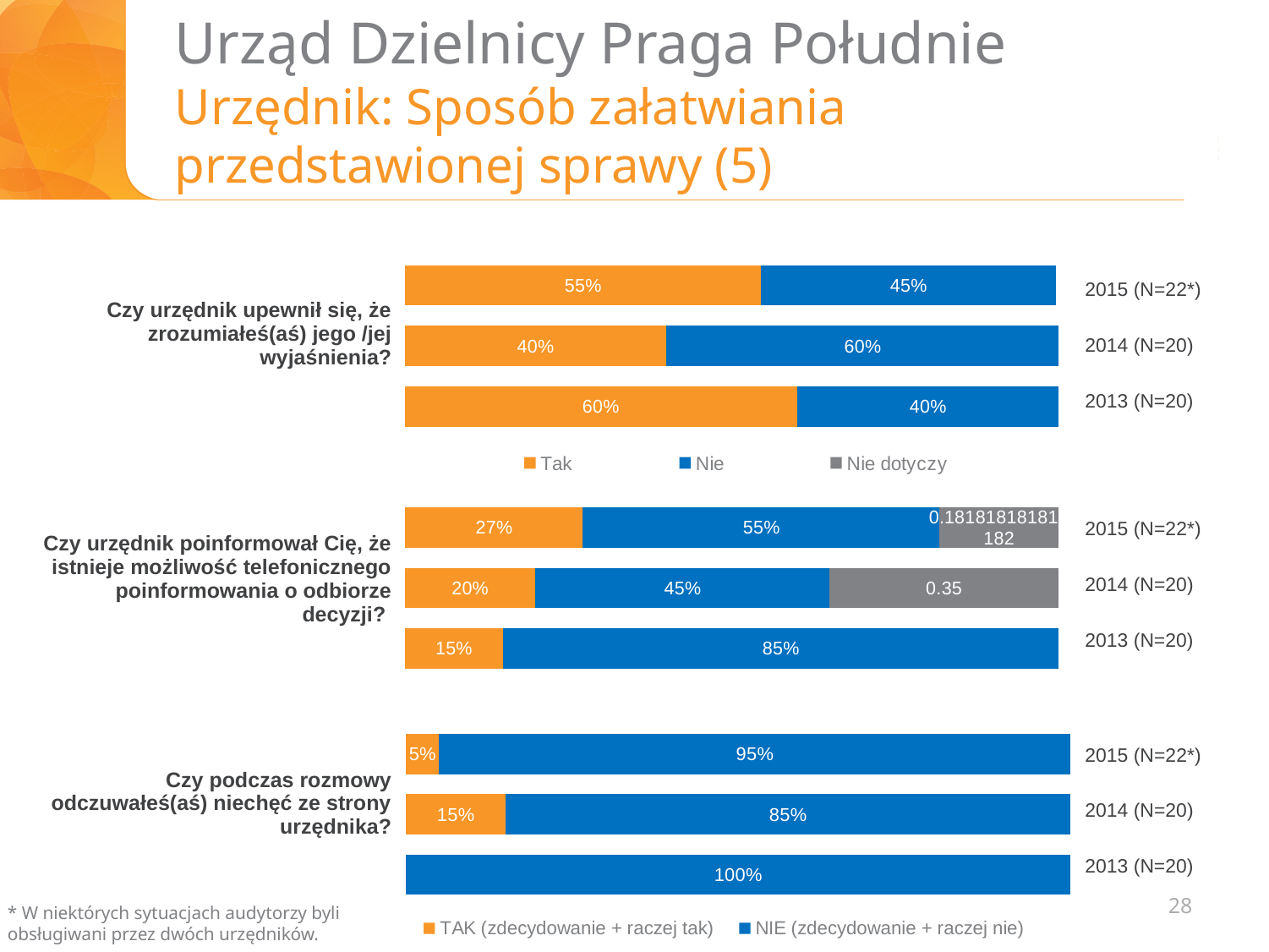
In the chart for "Czy podczas rozmowy odczuwałeś(aś) niechęć ze strony urzędnika?", is the TAK value for 2014 (N=20) larger or smaller than the TAK value for 2015 (N=22*)? larger In the chart for "Czy urzędnik poinformował Cię, że istnieje możliwość telefonicznego poinformowania o odbiorze decyzji?", which year has the lowest Tak value? 2013 (N=20) In the chart for "Czy urzędnik poinformował Cię, że istnieje możliwość telefonicznego poinformowania o odbiorze decyzji?", what is the Nie dotyczy value shown for 2014 (N=20)? 0.35 In the chart for "Czy urzędnik upewnił się, że zrozumiałeś(aś) jego /jej wyjaśnienia?", how many entries does the legend list? 3 In the chart for "Czy urzędnik upewnił się, że zrozumiałeś(aś) jego /jej wyjaśnienia?", what is the Nie value for 2014 (N=20)? 60% In the chart for "Czy urzędnik upewnił się, że zrozumiałeś(aś) jego /jej wyjaśnienia?", which year has the highest Tak value? 2013 (N=20) What type of chart is used on this slide? Stacked bar chart In the chart for "Czy urzędnik poinformował Cię, że istnieje możliwość telefonicznego poinformowania o odbiorze decyzji?", what is the difference between the Nie values for 2013 (N=20) and 2014 (N=20)? 40% In the chart for "Czy urzędnik poinformował Cię, że istnieje możliwość telefonicznego poinformowania o odbiorze decyzji?", what is the Nie value for 2013 (N=20)? 85% In the chart for "Czy urzędnik upewnił się, że zrozumiałeś(aś) jego /jej wyjaśnienia?", what is the Tak value for 2015 (N=22*)? 55% In the chart for "Czy podczas rozmowy odczuwałeś(aś) niechęć ze strony urzędnika?", what is the NIE value for 2015 (N=22*)? 95% In the chart for "Czy podczas rozmowy odczuwałeś(aś) niechęć ze strony urzędnika?", which year shows 100% for NIE? 2013 (N=20)